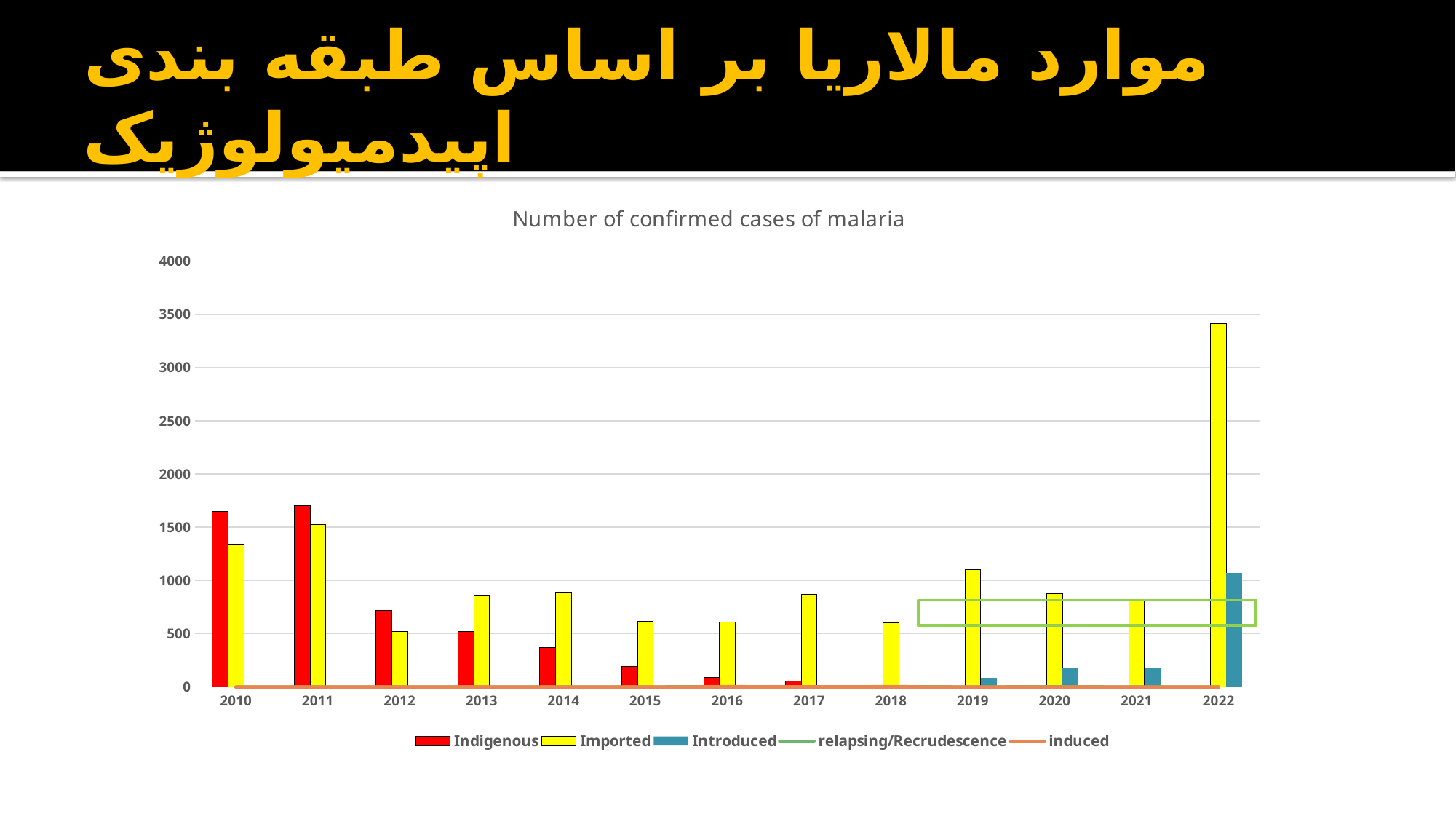
Is the value for Introduced in 2022 greater or less than 500? greater Does the Indigenous series rise or fall from 2011 to 2018? fall In which year is the Indigenous series highest? 2011 How many years are shown on the x axis of the chart? 13 What is the title of the chart? Number of confirmed cases of malaria How many series does the chart legend list? 5 Is the value for Imported in 2012 greater or less than 1000? less In which year is the Imported series highest? 2022 Is the value for Imported in 2022 greater or less than 3000? greater In 2010, which is larger: Indigenous or Imported? Indigenous What kind of chart is shown on the slide? combination bar and line chart